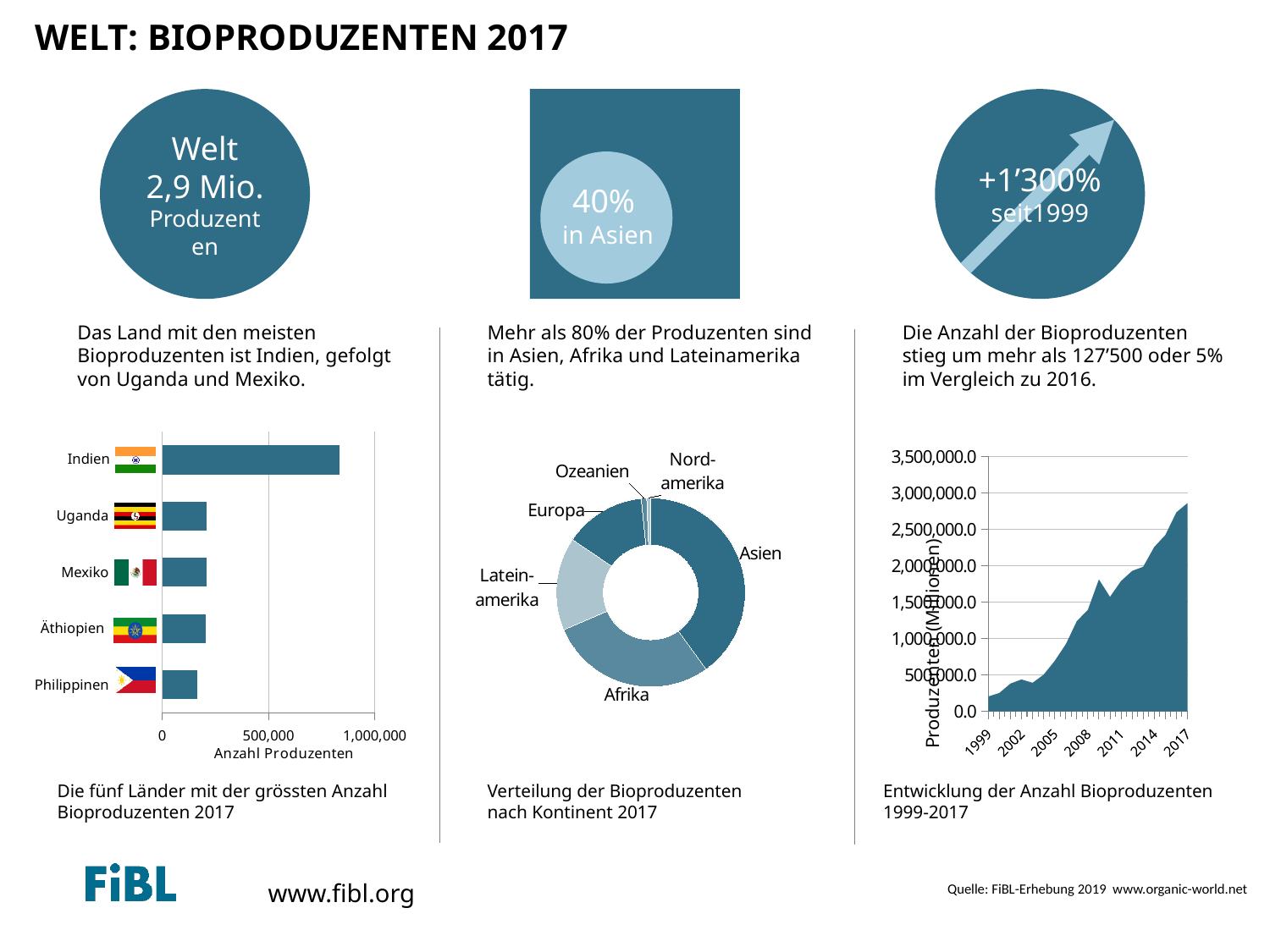
In the bar chart 'Die fünf Länder mit der grössten Anzahl Bioproduzenten 2017', is the value for Indien greater or less than 500,000? greater In the bar chart 'Die fünf Länder mit der grössten Anzahl Bioproduzenten 2017', is the value for Uganda greater or less than 500,000? less In the chart 'Entwicklung der Anzahl Bioproduzenten 1999-2017', do the values generally rise or fall from 1999 to 2017? Rise What kind of chart is 'Die fünf Länder mit der grössten Anzahl Bioproduzenten 2017'? Bar chart In the bar chart 'Die fünf Länder mit der grössten Anzahl Bioproduzenten 2017', which country has the highest number of producers? Indien How many continents are shown in the donut chart 'Verteilung der Bioproduzenten nach Kontinent 2017'? 6 In the chart 'Entwicklung der Anzahl Bioproduzenten 1999-2017', is the value for 2017 greater or less than 2,500,000? greater What is the x-axis title of the bar chart 'Die fünf Länder mit der grössten Anzahl Bioproduzenten 2017'? Anzahl Produzenten In the donut chart 'Verteilung der Bioproduzenten nach Kontinent 2017', which continent has the largest share? Asien In the bar chart 'Die fünf Länder mit der grössten Anzahl Bioproduzenten 2017', which country has the lowest number of producers? Philippinen In the donut chart 'Verteilung der Bioproduzenten nach Kontinent 2017', which has the larger share, Afrika or Europa? Afrika How many countries are shown in the bar chart 'Die fünf Länder mit der grössten Anzahl Bioproduzenten 2017'? 5